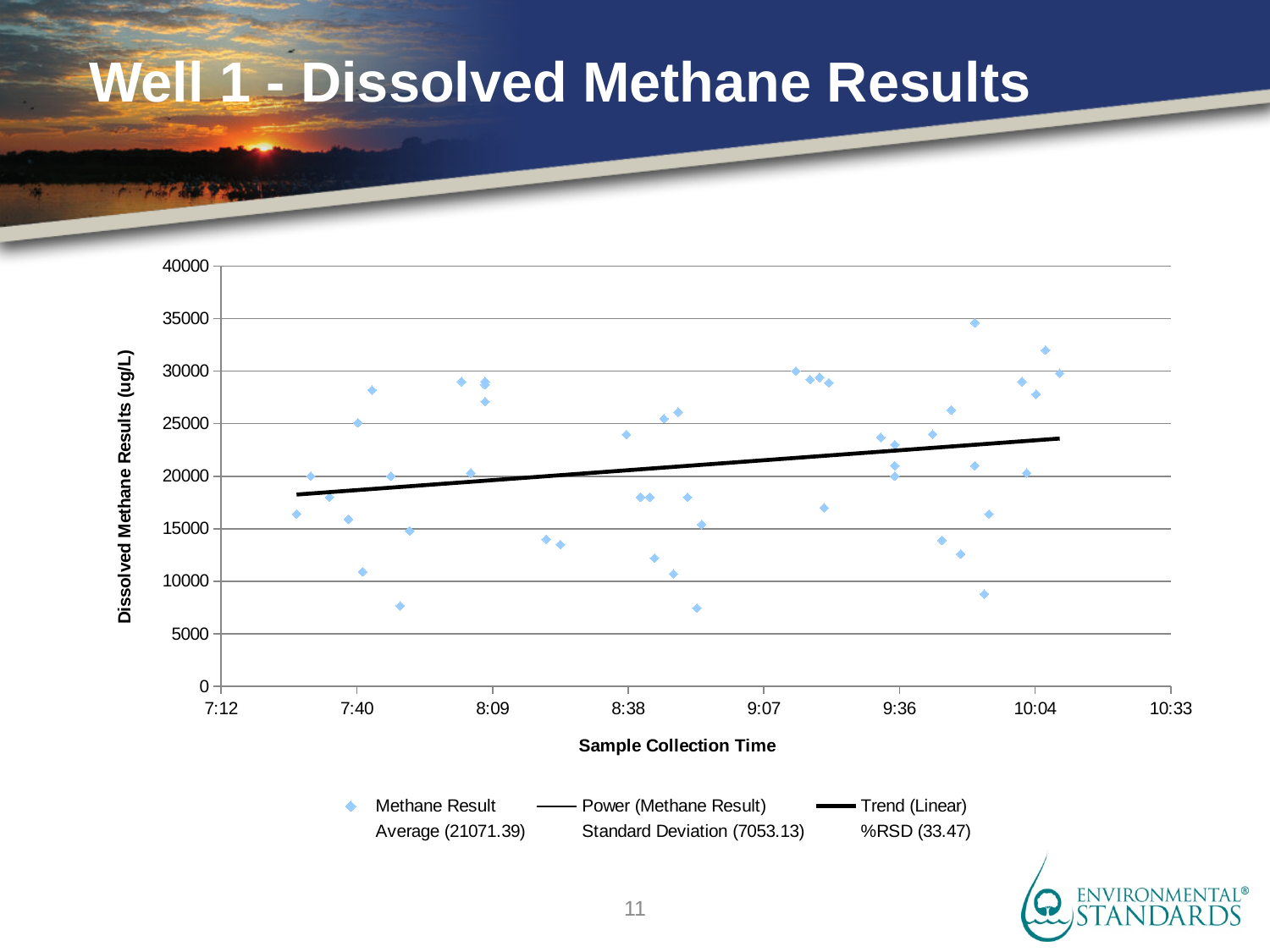
What is the label of the y axis? Dissolved Methane Results (ug/L) How many series does the legend list? 6 Is the highest plotted methane result greater or less than 30000? greater What kind of chart is shown on the slide? scatter chart Does the linear trend line rise or fall from left to right across the sample collection times? rises What average value is printed in the legend for the Methane Result series? 21071.39 Is the value of the linear trend line at its left end (around 7:30) greater or less than 20000? less What is the maximum value shown on the y axis? 40000